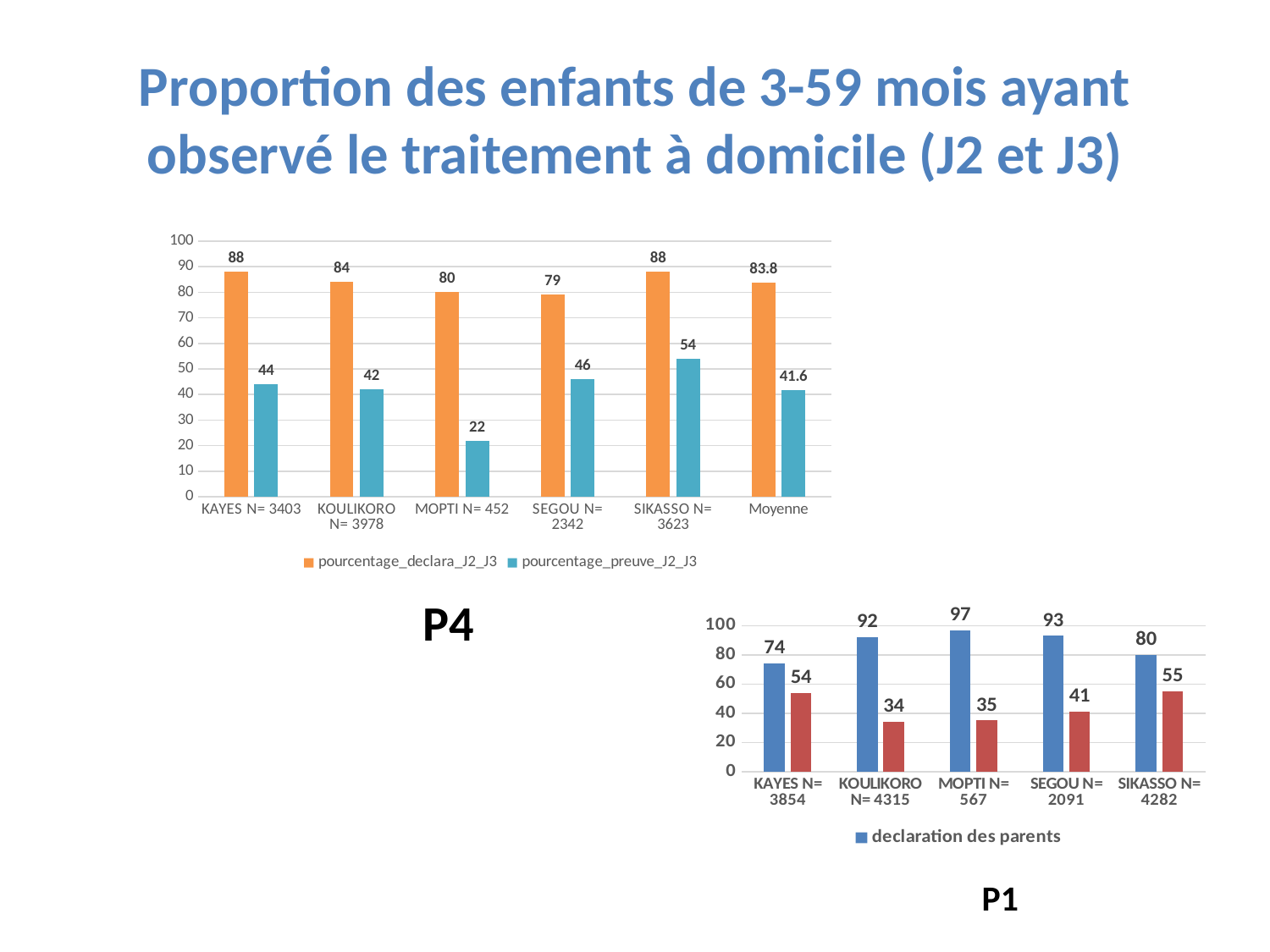
What kind of chart is the bottom-right chart (P1)? bar chart In the top chart (P4), what is the pourcentage_preuve_J2_J3 value for Moyenne? 41.6 In the top chart (P4), which category has the highest pourcentage_preuve_J2_J3 value? SIKASSO N= 3623 In the bottom-right chart (P1), which category has the lowest blue bar value? KAYES N= 3854 In the top chart (P4), what is the difference between the pourcentage_declara_J2_J3 and pourcentage_preuve_J2_J3 values for SEGOU N= 2342? 33 In the bottom-right chart (P1), what is the value of the red bar for KOULIKORO N= 4315? 34 In the bottom-right chart (P1), what is the value of the blue bar for MOPTI N= 567? 97 In the top chart (P4), which category has the lowest pourcentage_preuve_J2_J3 value? MOPTI N= 452 In the top chart (P4), what is the pourcentage_preuve_J2_J3 value for MOPTI N= 452? 22 In the bottom-right chart (P1), is the red bar for SIKASSO N= 4282 larger or smaller than the red bar for SEGOU N= 2091? larger In the top chart (P4), how many series does the legend list? 2 In the top chart (P4), what is the pourcentage_declara_J2_J3 value for KAYES N= 3403? 88